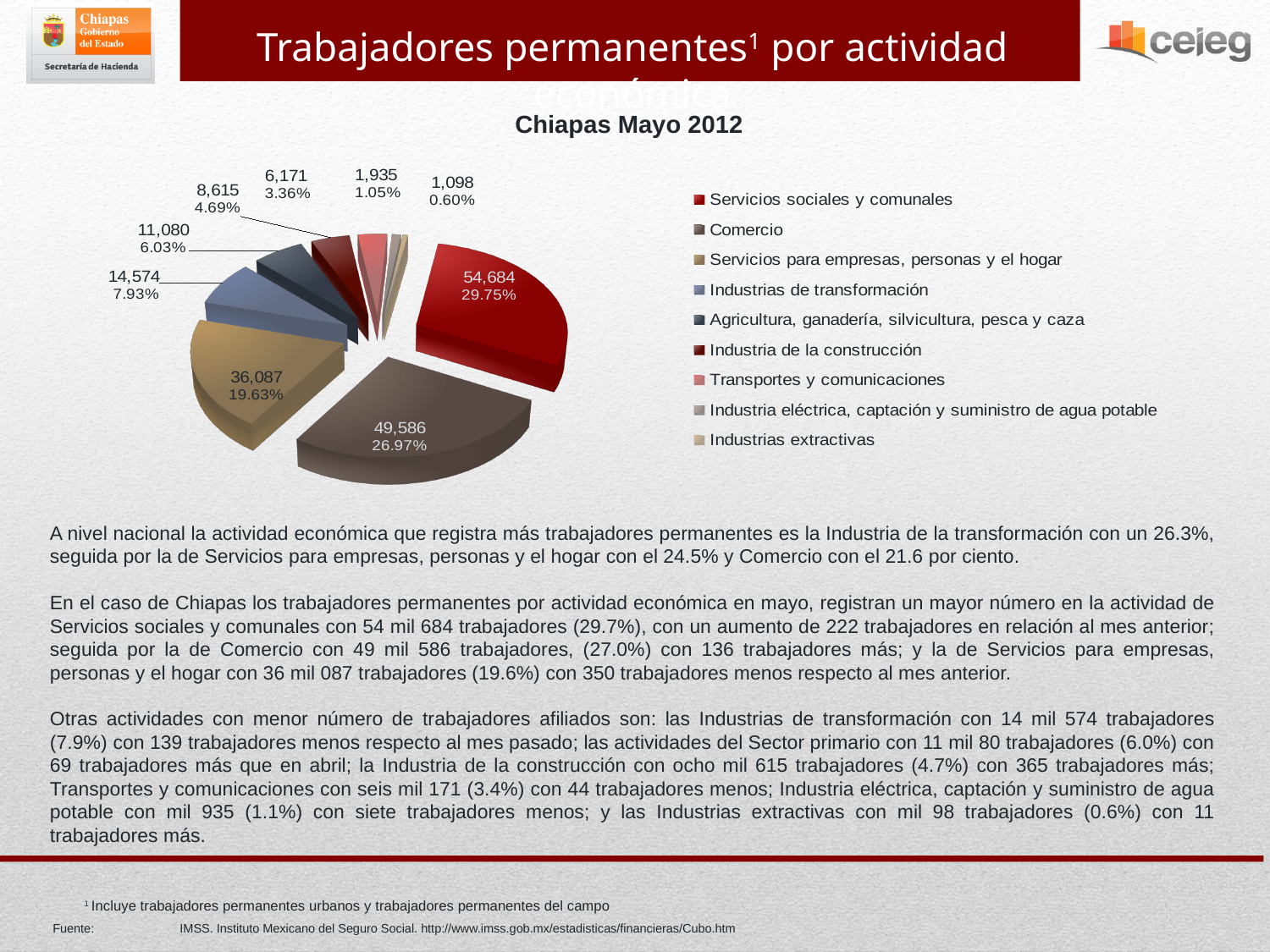
What is the value shown for Servicios sociales y comunales? 54,684 What is the value shown for Servicios para empresas, personas y el hogar? 36,087 What kind of chart is shown on the slide? Pie chart Which is larger, the value for Industrias de transformación or for Agricultura, ganadería, silvicultura, pesca y caza? Industrias de transformación How many entries does the legend list? 9 What percentage share does Industria eléctrica, captación y suministro de agua potable have? 1.05% What percentage share does Comercio have in the pie chart? 26.97% Which activity has the smallest slice in the pie chart? Industrias extractivas What is the subtitle shown above the chart? Chiapas Mayo 2012 What is the difference between the values for Servicios sociales y comunales and Comercio? 5,098 Which activity has the largest slice in the pie chart? Servicios sociales y comunales How many slices does the pie chart have? 9